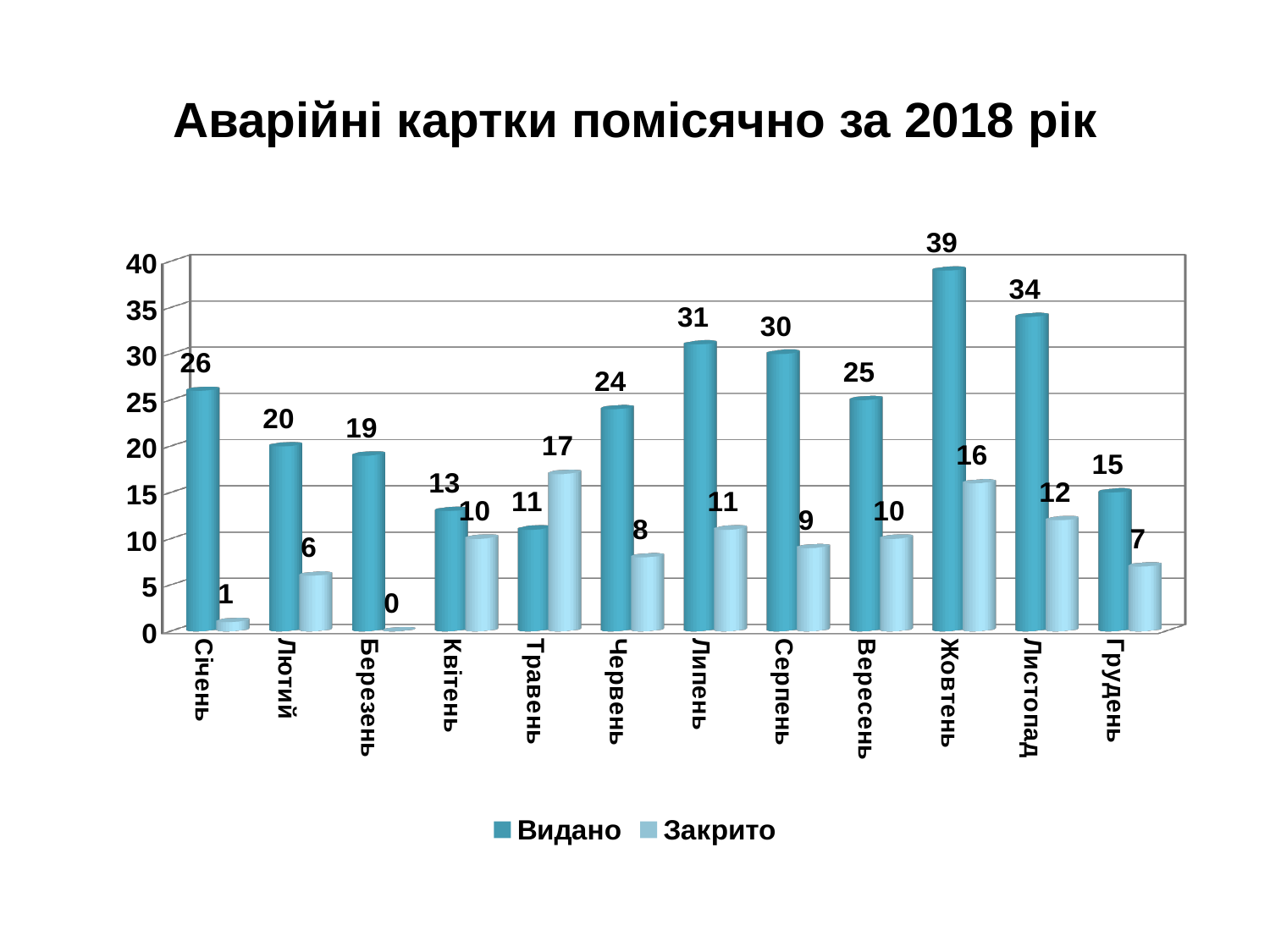
What is the value of Видано for Жовтень? 39 What is the value of Закрито for Травень? 17 Which month has the lowest Закрито value? Березень How many series does the legend list? 2 What is the title of the chart? Аварійні картки помісячно за 2018 рік How many months are shown on the x axis? 12 What is the difference in Видано between Жовтень and Січень? 13 What kind of chart is shown on the slide? Bar chart Which month has the highest Видано value? Жовтень Which is larger for Травень: Видано or Закрито? Закрито What is the value of Закрито for Березень? 0 What is the difference between Видано and Закрито for Листопад? 22